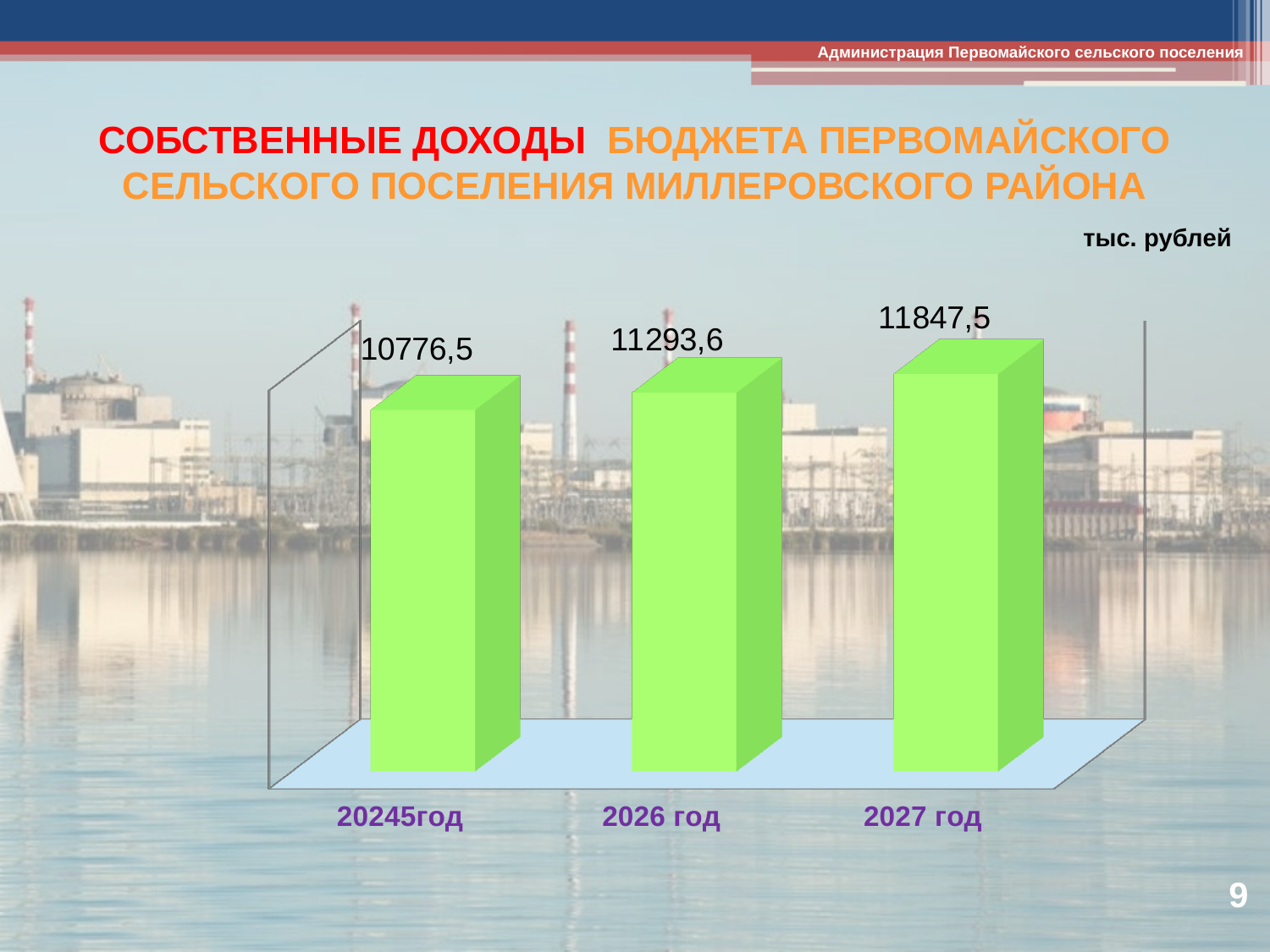
Which is larger, the value for 2026 год or the value for 2027 год? 2027 год How many bars are shown in the chart? 3 What is the difference between the values for 2027 год and 2026 год? 553,9 What is the value shown for 2027 год? 11847,5 Which bar has the lowest value? 20245год In what units are the values on the chart given? тыс. рублей What is the difference between the values for 2026 год and the first bar (20245год)? 517,1 What is the value shown for 2026 год? 11293,6 What kind of chart is shown on the slide? Bar chart What is the value shown for the first bar, labelled 20245год? 10776,5 Which year has the highest value? 2027 год Do the values rise or fall from left to right across the years? Rise